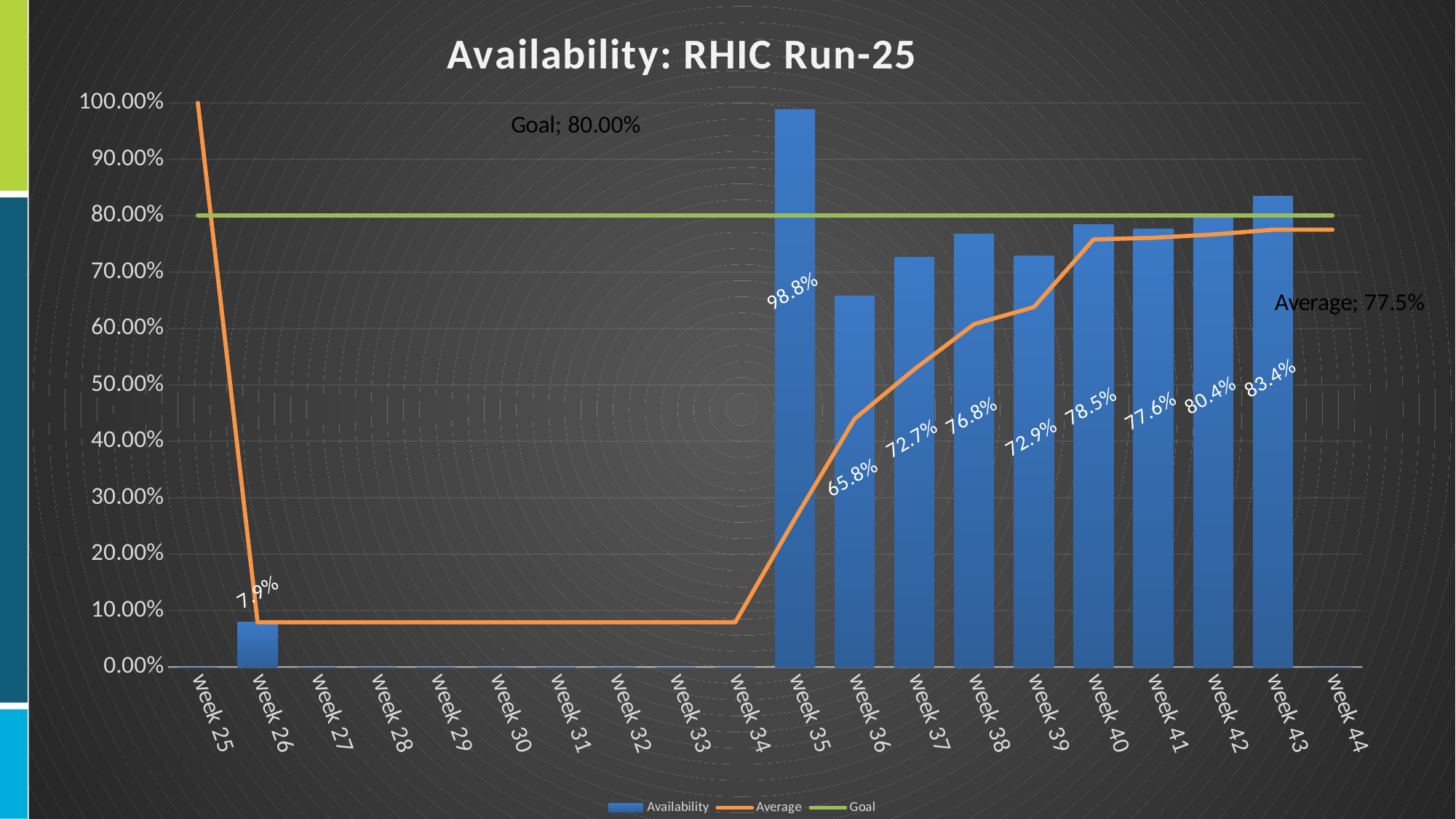
Which week has the highest availability bar? week 35 Is the availability value for week 36 greater or less than 70.00%? less What is the availability value for week 35? 98.8% How many series does the legend list? 3 What is the difference between the availability for week 43 and week 42? 3.0% Do the availability bars rise or fall from week 36 to week 38? rise What kind of chart is this? bar chart with line series What value is shown for the Goal line? 80.00% What is the availability value for week 26? 7.9% How many weeks are shown on the x axis? 20 Which has the higher availability, week 38 or week 39? week 38 What is the availability value for week 43? 83.4%